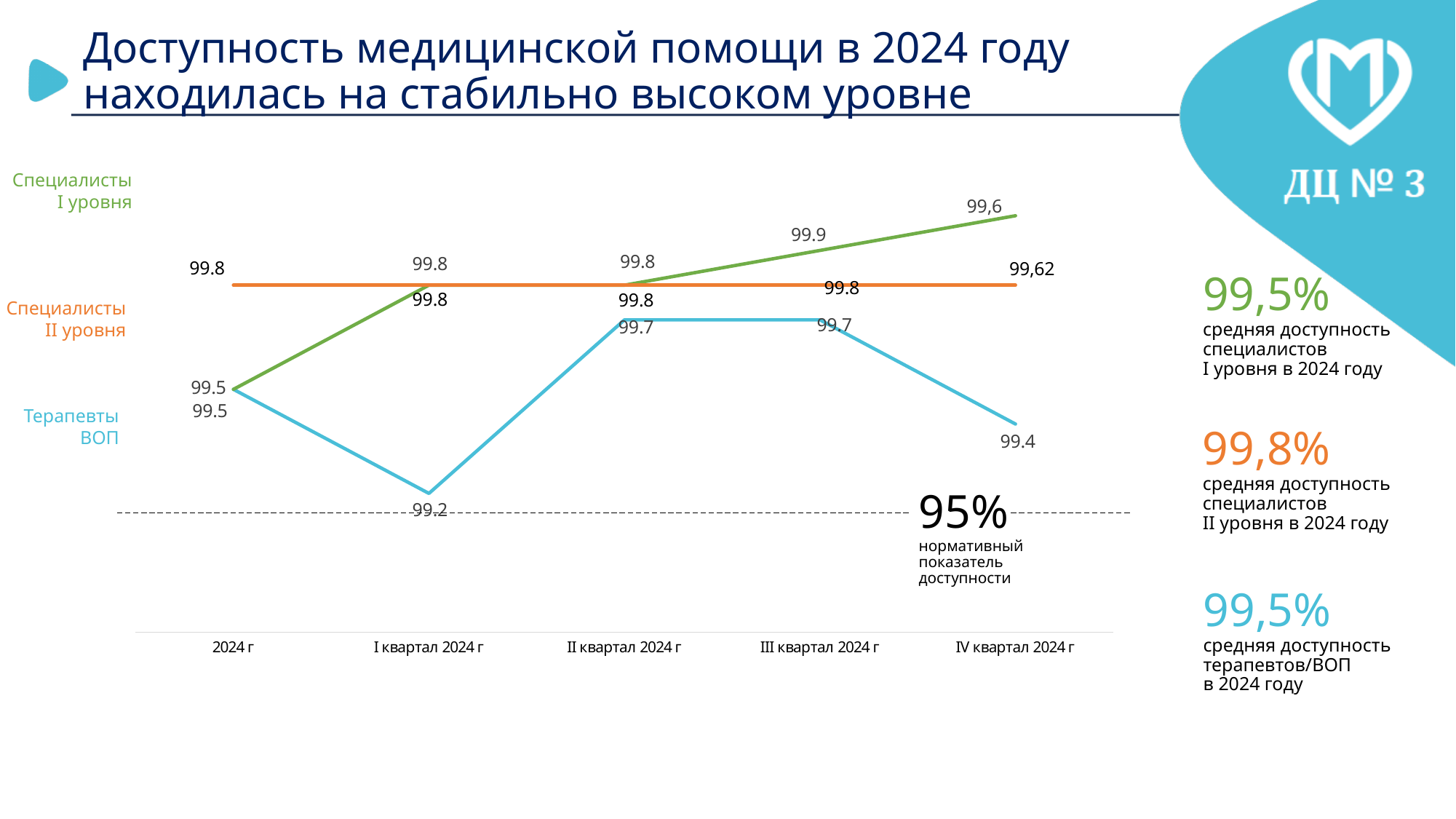
What is the value for Специалисты II уровня at 2024 г? 99.8 What is the value for Терапевты ВОП at IV квартал 2024 г? 99.4 Does the Терапевты ВОП line rise or fall from III квартал 2024 г to IV квартал 2024 г? fall At which x-axis point is the value for Терапевты ВОП lowest? I квартал 2024 г How many series are plotted on the chart? 3 What is the value for Специалисты I уровня at III квартал 2024 г? 99.9 At IV квартал 2024 г, which is larger: Специалисты I уровня or Терапевты ВОП? Специалисты I уровня What is the value for Терапевты ВОП at I квартал 2024 г? 99.2 How many points along the x axis does the chart have? 5 What is the difference between the Терапевты ВОП values at II квартал 2024 г and I квартал 2024 г? 0.5 What kind of chart is shown on the slide? line chart